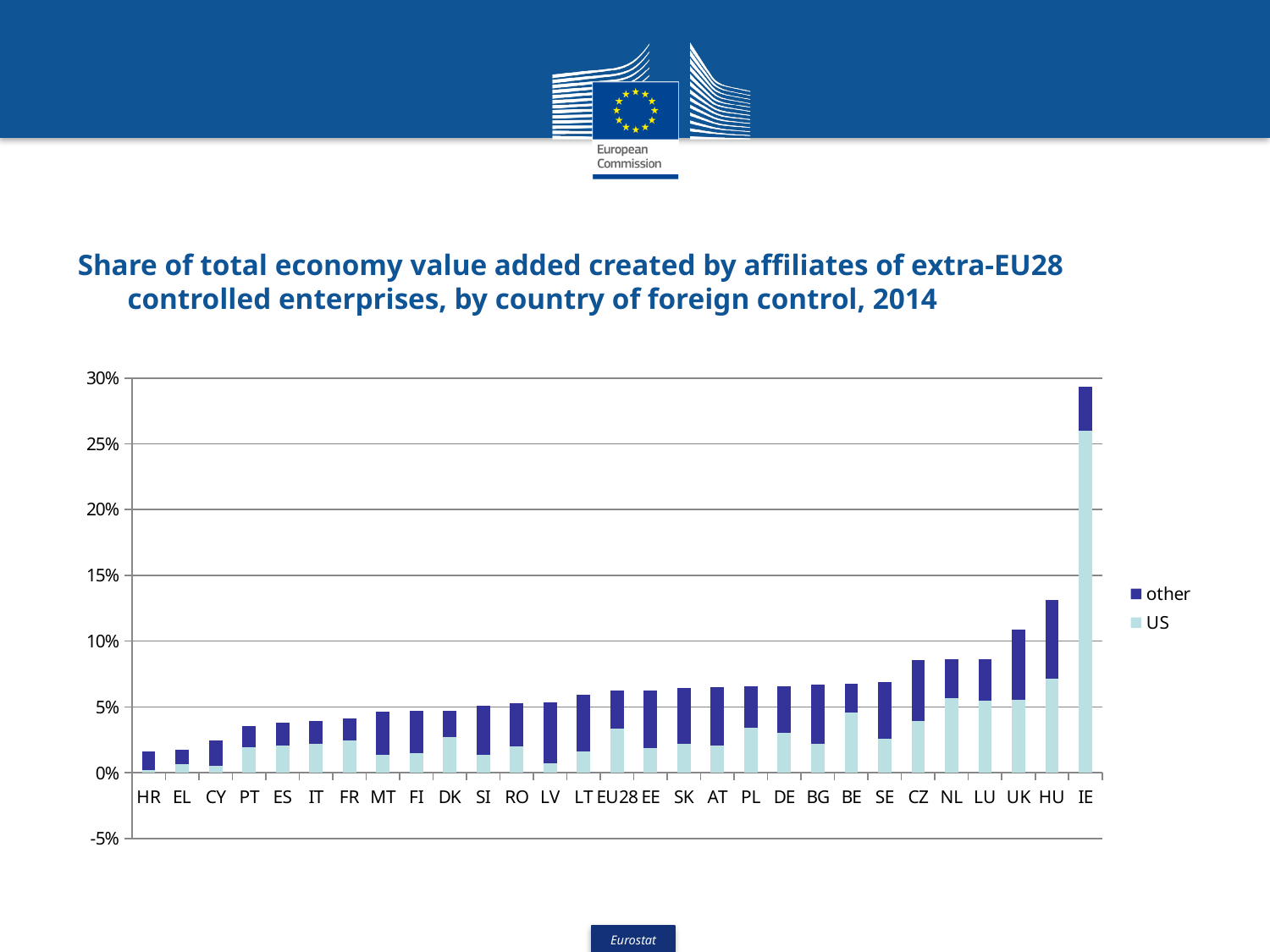
Which has the larger total share, HU or UK? HU What year does the chart title refer to? 2014 How many countries/categories are shown on the x axis? 29 How many series does the legend list? 2 Is the total value for NL greater or less than 10%? less Do the total bar heights generally rise or fall from left to right along the x axis? rise Is the total value for HU greater or less than 10%? greater Is the total value for HR greater or less than 5%? less Which category has the highest total share? IE What kind of chart is shown on the slide? stacked bar chart Which series are listed in the legend? other, US